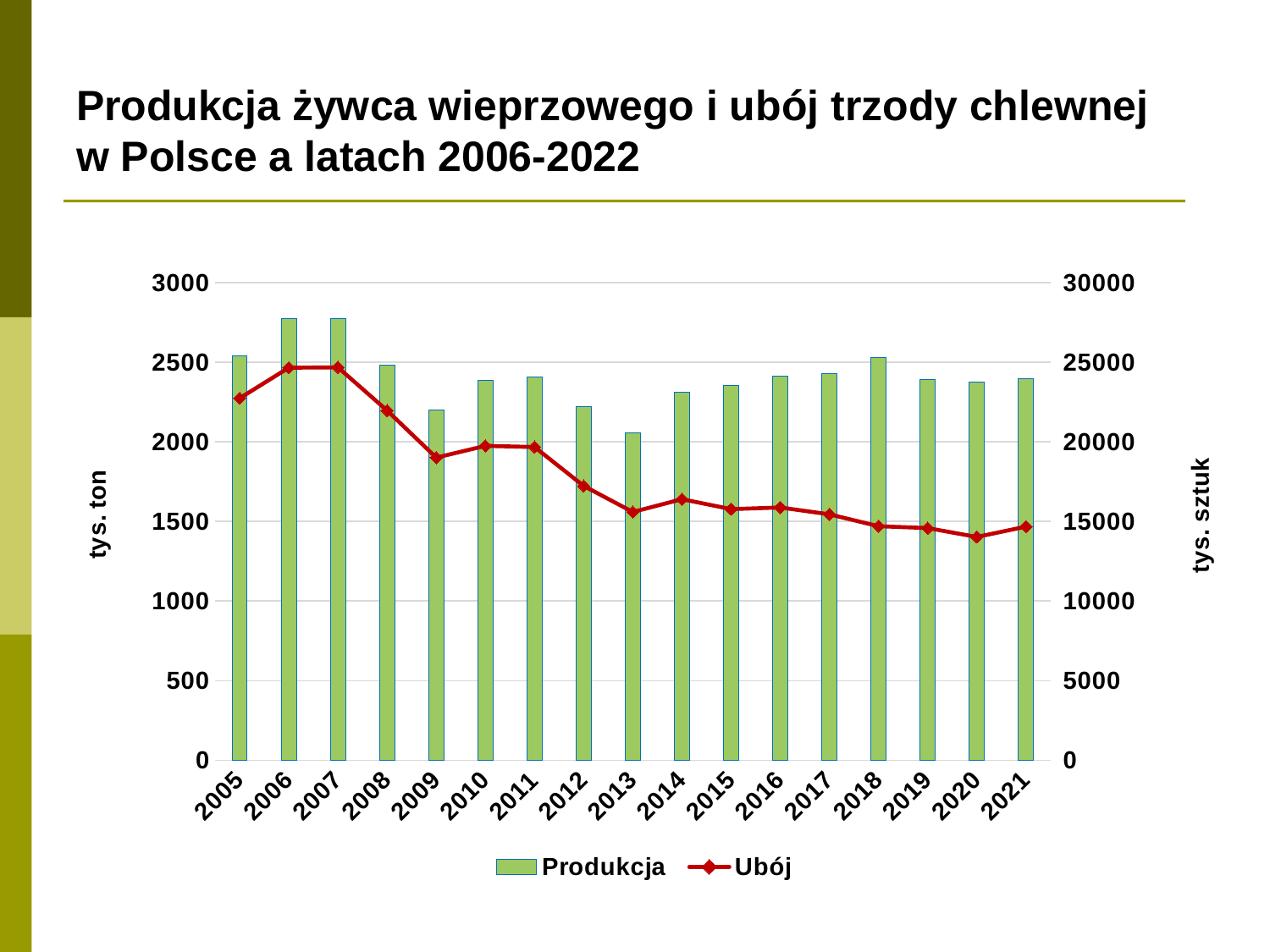
Which year has the lowest Produkcja bar? 2013 In which year is the Ubój line at its lowest point? 2020 What unit is shown on the right-hand axis? tys. sztuk Does the Ubój line generally rise or fall from 2007 to 2021? fall What kind of chart is shown on the slide? A combined bar and line chart How many years are shown on the x axis? 17 Is the Produkcja value for 2009 greater or less than 2500? less How many series does the legend list? 2 Is the Ubój value for 2020 greater or less than 15000? less Is the Produkcja value for 2006 greater or less than 2500? greater Which is larger, the Produkcja value for 2005 or for 2013? 2005